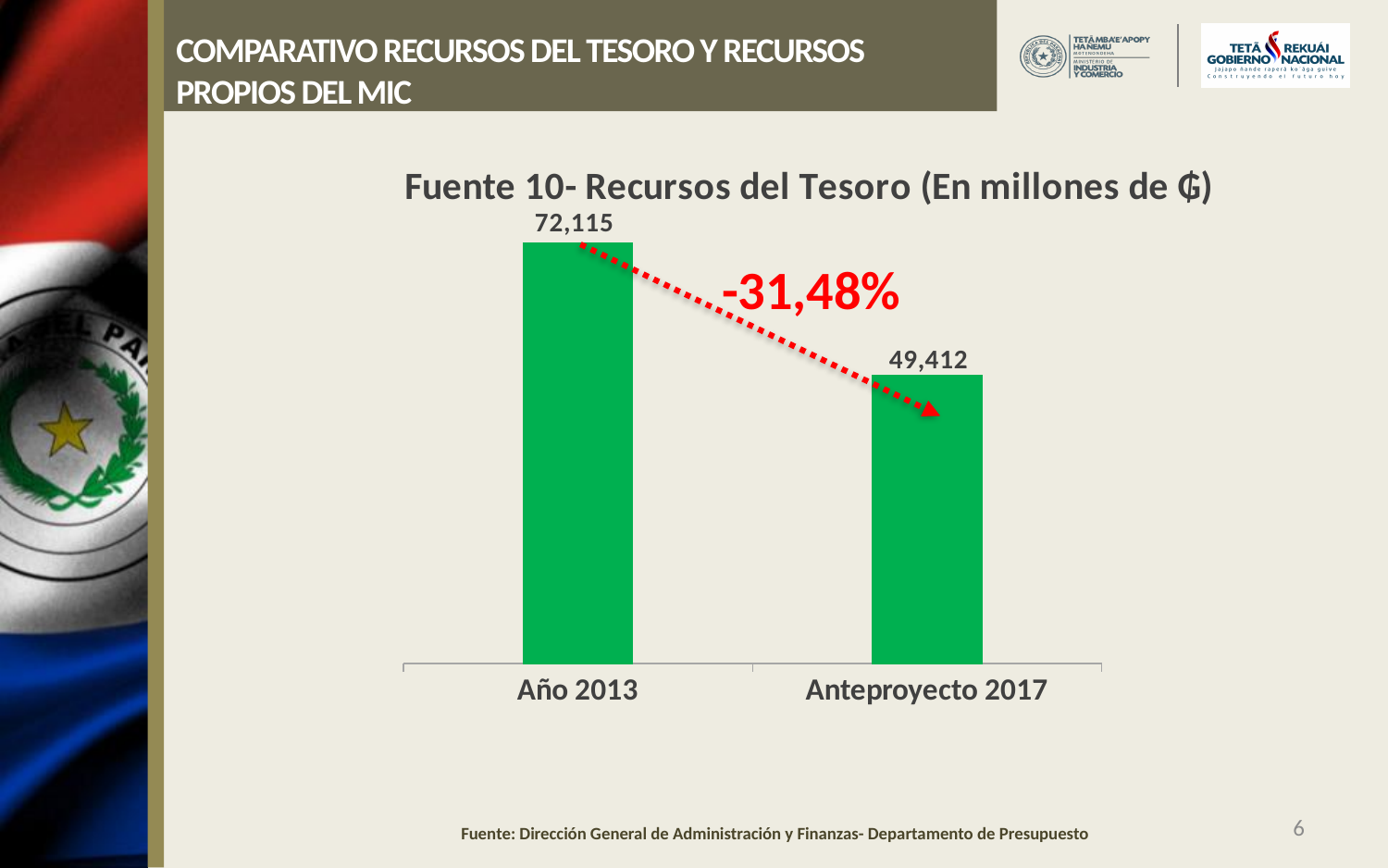
What kind of chart is shown on the slide? Bar chart Which category has the lowest value? Anteproyecto 2017 How many categories are shown on the x axis? 2 What is the value for Año 2013? 72,115 What is the difference between the values for Año 2013 and Anteproyecto 2017? 22,703 Which category has the highest value? Año 2013 What percentage change is annotated on the chart between the two bars? -31,48% Which is larger, the value for Año 2013 or the value for Anteproyecto 2017? Año 2013 Do the values rise or fall from Año 2013 to Anteproyecto 2017? Fall What is the title of the chart? Fuente 10- Recursos del Tesoro (En millones de ₲) What is the value for Anteproyecto 2017? 49,412